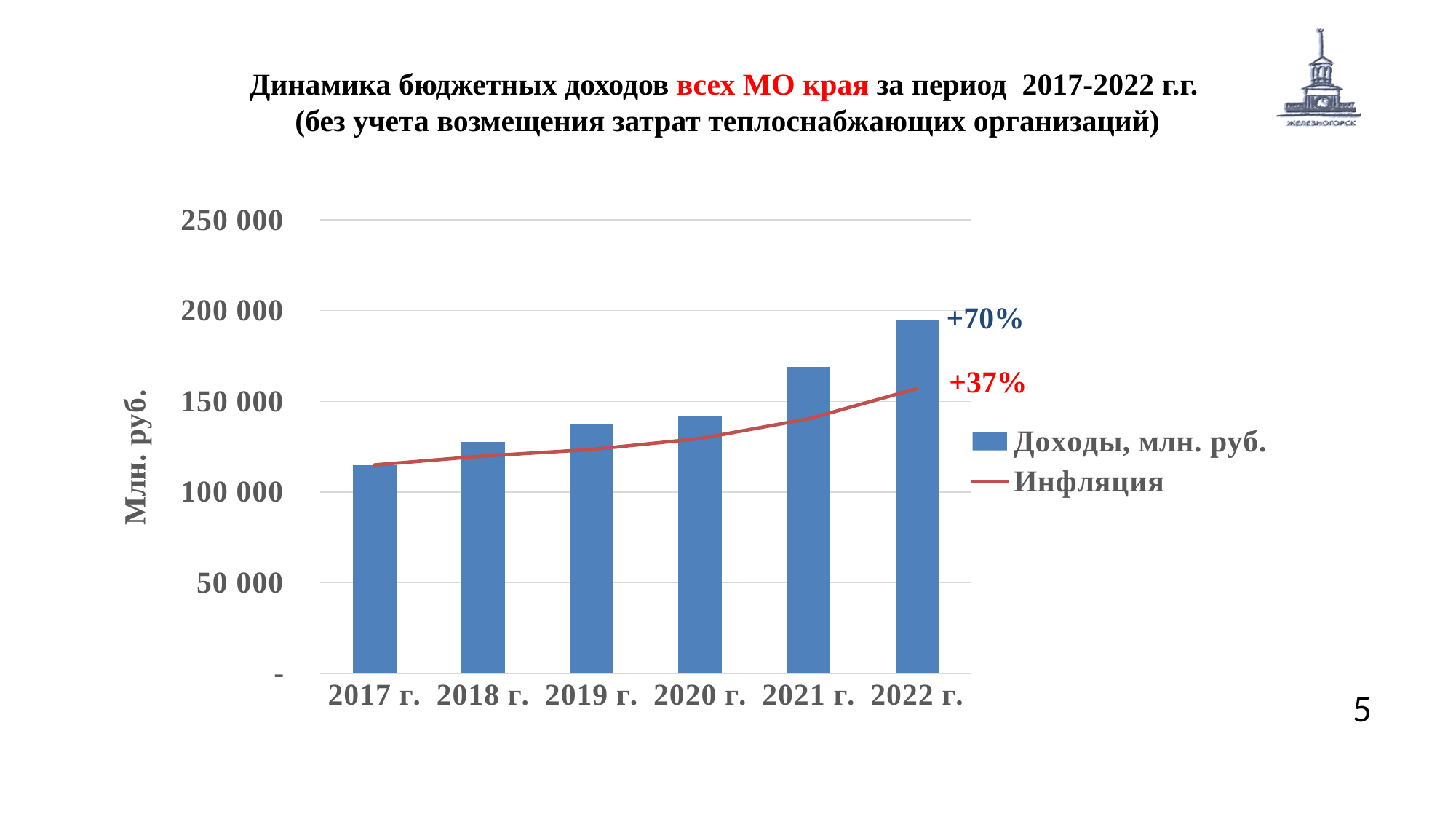
Which year has the lowest Доходы bar? 2017 г. Is the Доходы value for 2022 г. greater or less than 200 000? less What kind of chart is shown on the slide? Bar chart with a line How many series does the legend list? 2 What is the label on the vertical axis of the chart? Млн. руб. How many years are shown on the x axis of the chart? 6 Is the Доходы value for 2017 г. greater or less than 100 000? greater Which is larger, the Доходы value for 2021 г. or for 2019 г.? 2021 г. Do the Доходы values rise or fall from 2017 to 2022? Rise What percentage growth is annotated next to the Доходы bar for 2022? +70% Is the Доходы value for 2021 г. greater or less than 150 000? greater Which year has the highest Доходы bar? 2022 г.